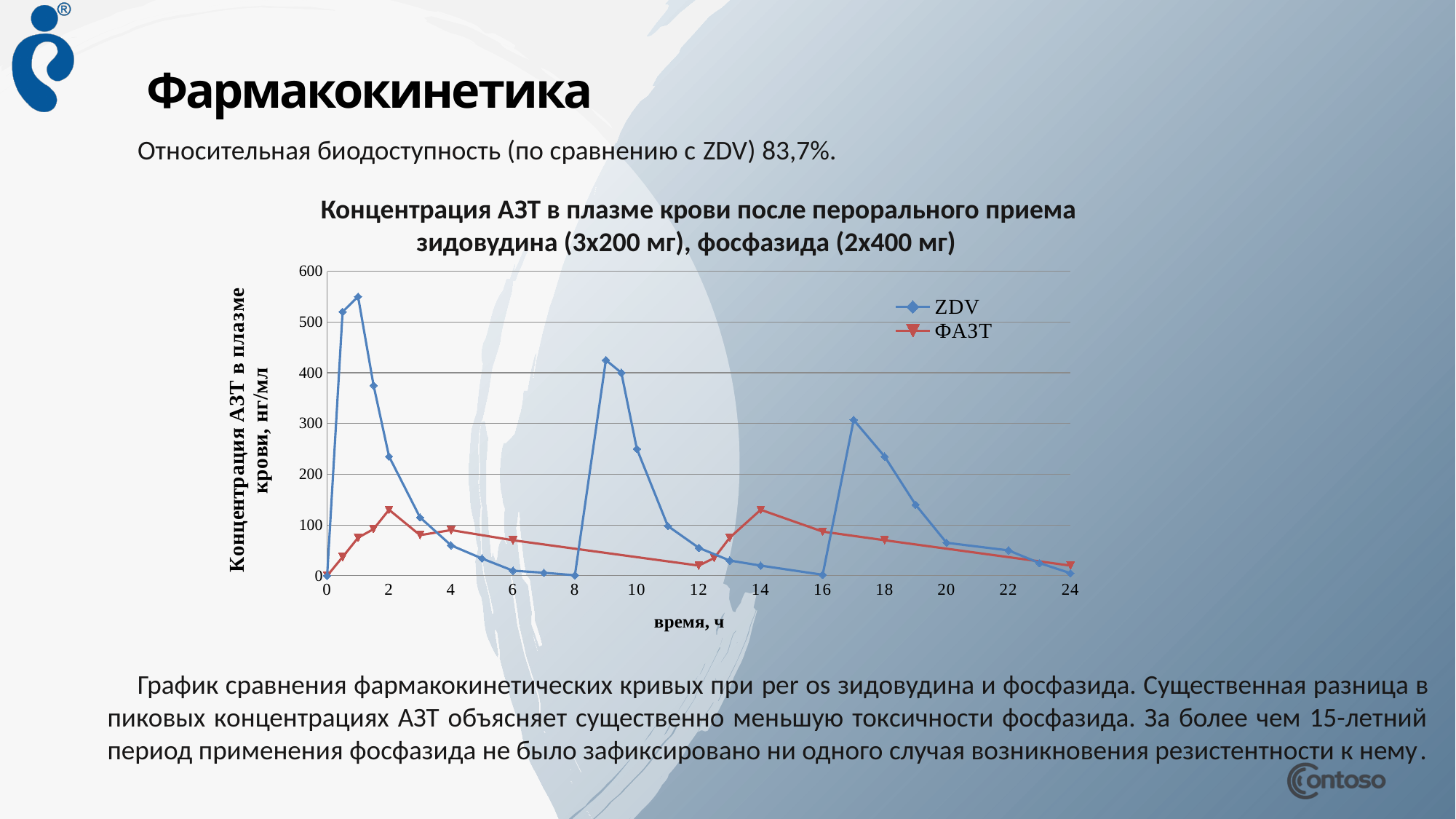
What is the label of the x axis of the chart? время, ч Which series has the higher value at 6 h, ZDV or ФАЗТ? ФАЗТ How many series does the chart legend list? 2 Is the ZDV value at 16 h greater or less than 100? less Which series reaches the highest peak concentration on the chart? ZDV Is the ФАЗТ value at 12 h greater or less than 100? less Is the ZDV value at 9 h greater or less than 400? greater What are the two series named in the chart legend? ZDV and ФАЗТ What kind of chart is shown on the slide? line chart Which series has the higher value at 1 h, ZDV or ФАЗТ? ZDV